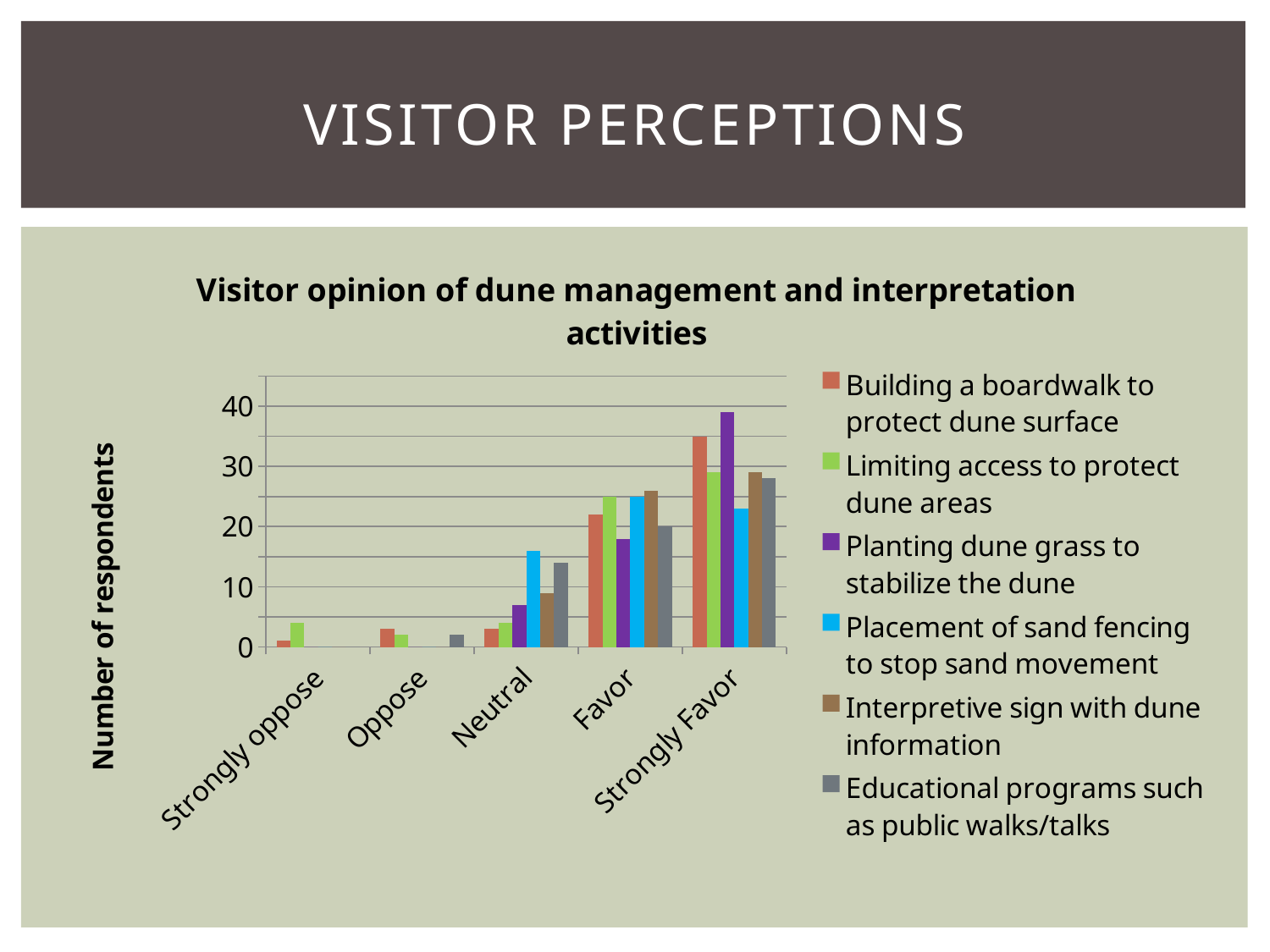
How many series does the legend list? 6 What is the title of the chart? Visitor opinion of dune management and interpretation activities Is the value for Placement of sand fencing to stop sand movement at Neutral greater or less than 10? greater In the Favor category, which is larger: Planting dune grass to stabilize the dune or Interpretive sign with dune information? Interpretive sign with dune information Which series has the highest value in the Strongly Favor category? Planting dune grass to stabilize the dune Is the value for Building a boardwalk to protect dune surface at Strongly Favor greater or less than 30? greater What kind of chart is shown on the slide? bar chart Is the value for Educational programs such as public walks/talks at Strongly Favor greater or less than 20? greater What is the title of the y axis? Number of respondents Which series has the lowest value in the Strongly Favor category? Placement of sand fencing to stop sand movement How many opinion categories are shown on the x axis? 5